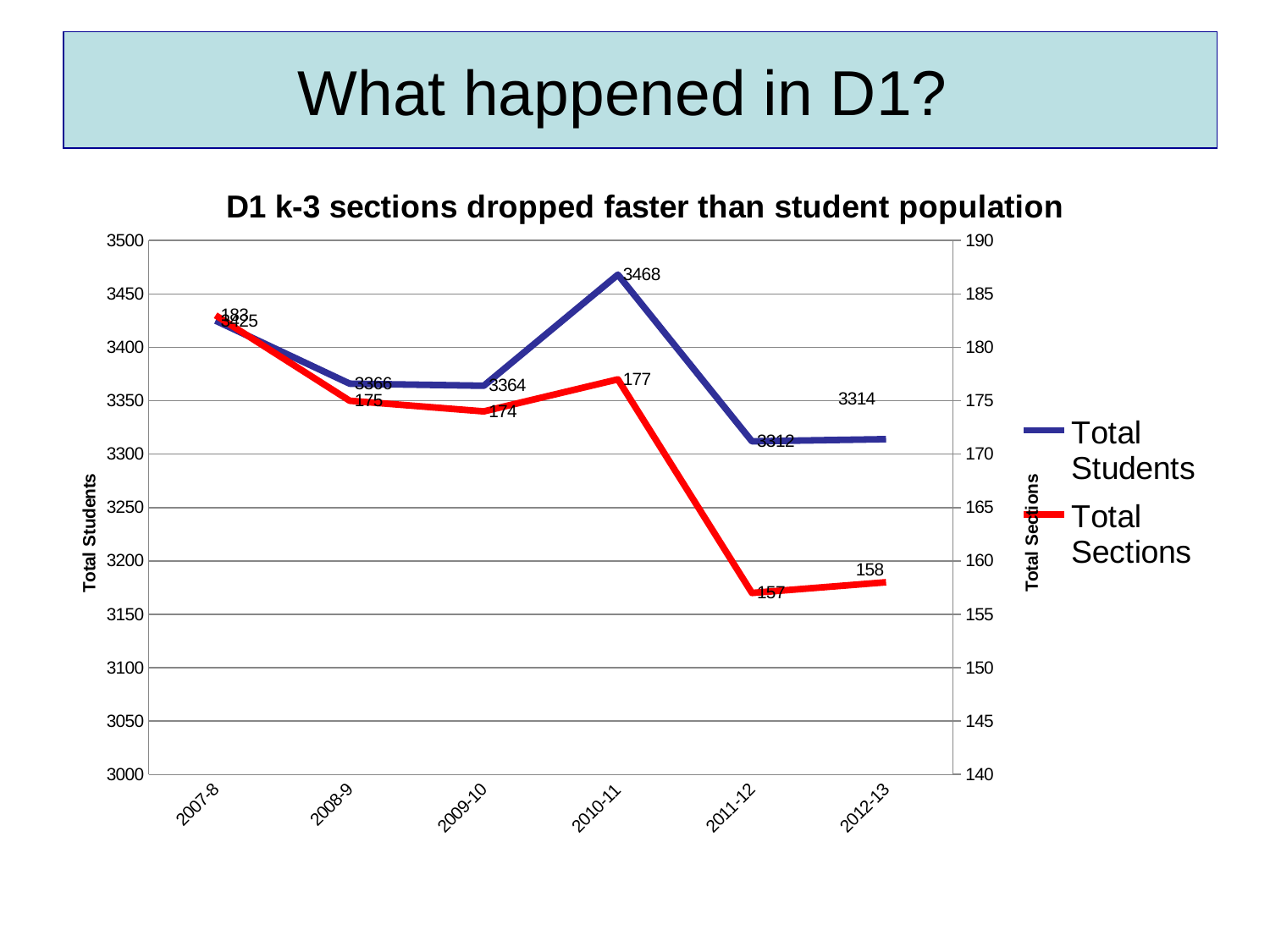
By how much did Total Sections fall from 2010-11 to 2011-12? 20 What kind of chart is shown on the slide? line chart Which year has more Total Students, 2008-9 or 2011-12? 2008-9 How many series does the legend list? 2 What is the title of the chart? D1 k-3 sections dropped faster than student population What is the value of Total Sections for 2011-12? 157 How many school years are plotted along the x axis? 6 In which school year is Total Students highest? 2010-11 What is the value of Total Sections for 2009-10? 174 What is the value of Total Students for 2012-13? 3314 What is the value of Total Students for 2010-11? 3468 In which school year is Total Sections lowest? 2011-12